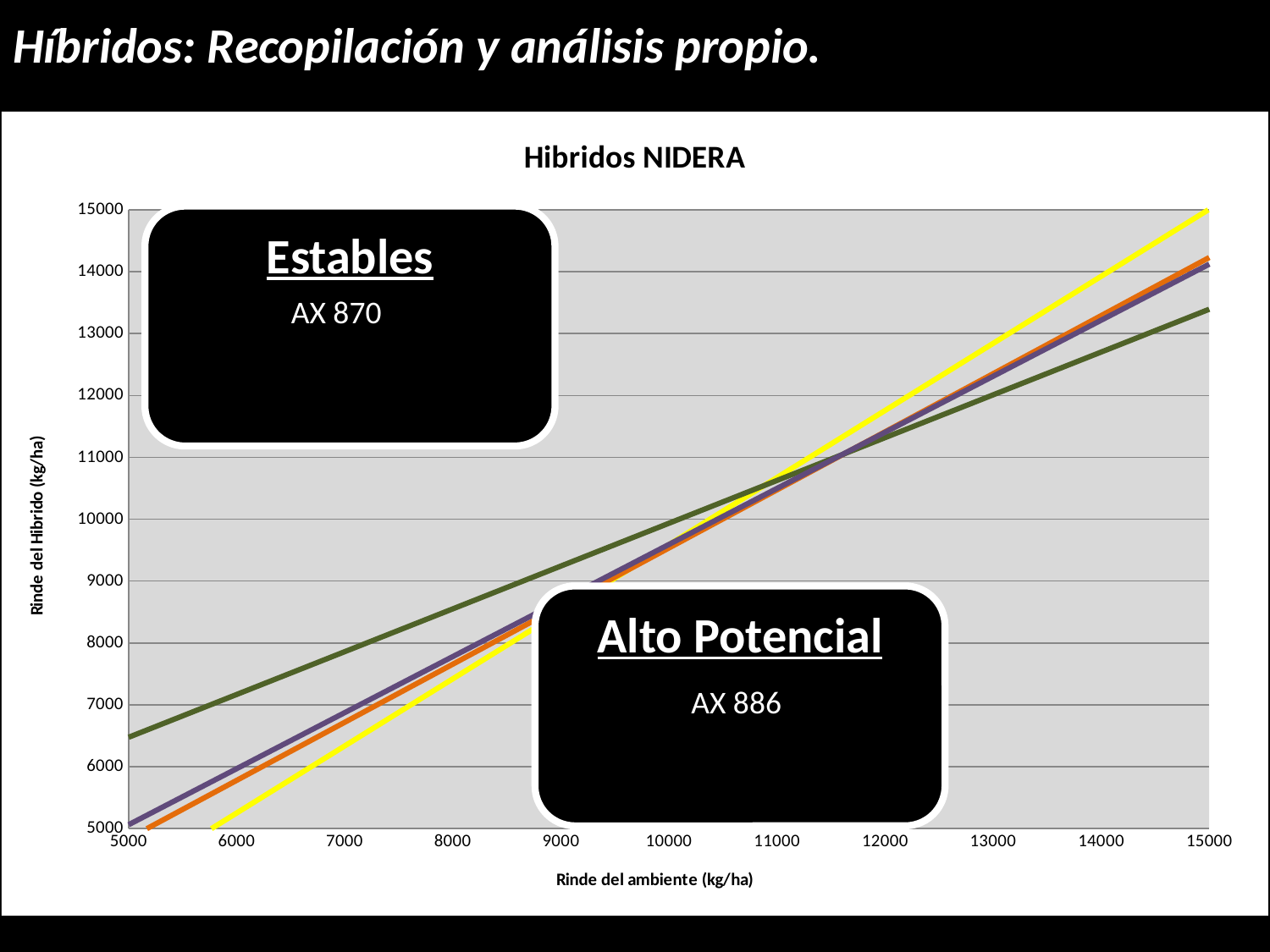
Which line is highest at Rinde del ambiente 5000 kg/ha? the green line What is the title of the chart? Hibridos NIDERA Is the value of the green line at Rinde del ambiente 15000 kg/ha greater or less than 14000? less Do the plotted lines rise or fall as Rinde del ambiente increases along the x axis? rise Which line is highest at Rinde del ambiente 15000 kg/ha? the yellow line Which hybrid is named in the box labelled 'Estables'? AX 870 How many lines are plotted on the chart? 4 Which line is lowest at Rinde del ambiente 15000 kg/ha? the green line What kind of chart is shown on the slide? line chart At Rinde del ambiente 15000 kg/ha, which is higher, the yellow line or the green line? the yellow line Is the value of the green line at Rinde del ambiente 5000 kg/ha greater or less than 6000? greater